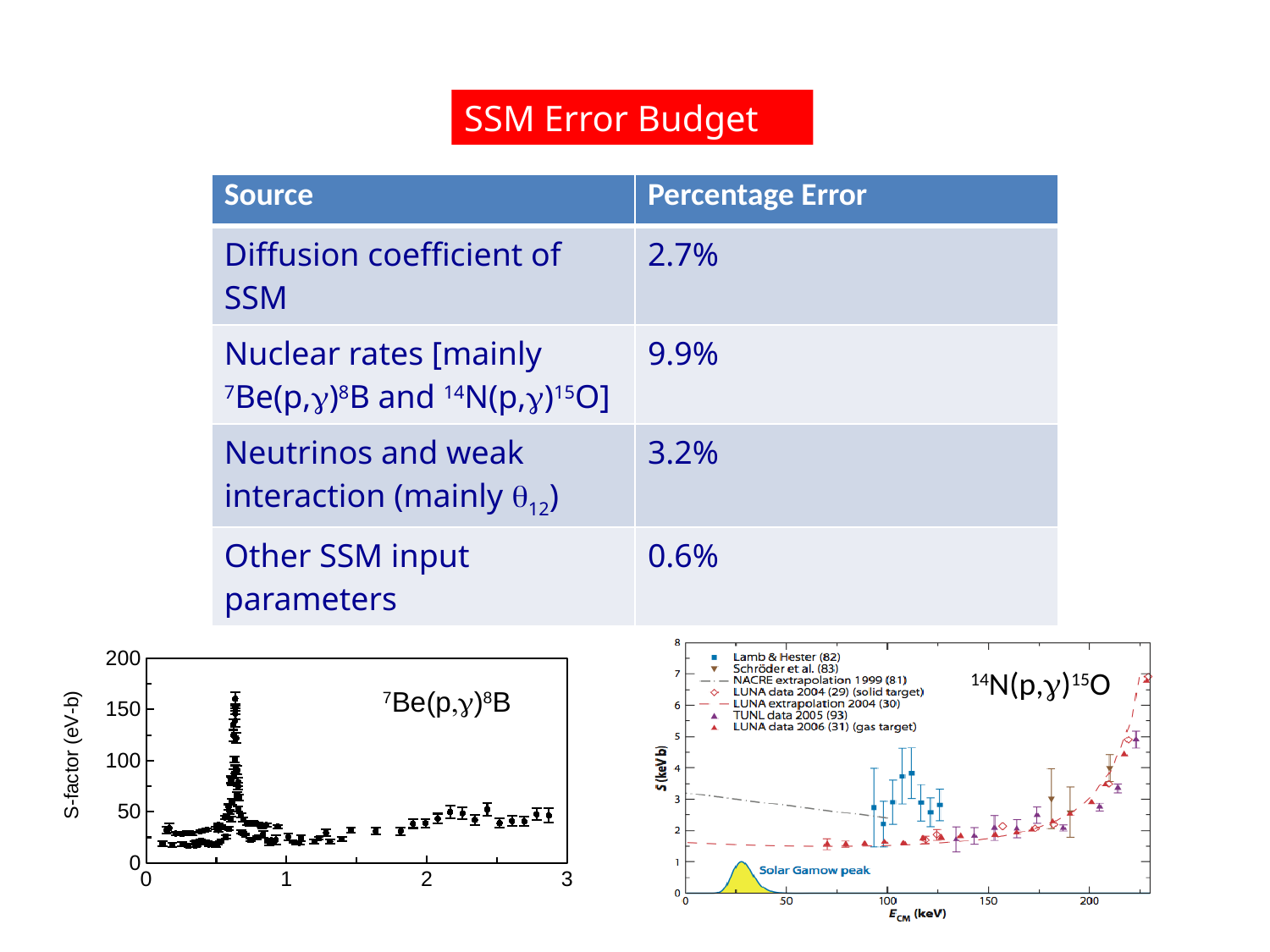
In the bottom-right 14N(p,γ)15O chart, are the LUNA data 2006 (gas target) points near 100 keV greater or less than 2 keV b? less How many data series does the legend of the bottom-right 14N(p,γ)15O chart list? 7 In the bottom-right 14N(p,γ)15O chart, do the S-factor values rise or fall as E_CM increases from 150 keV to 230 keV? rise What is the y-axis label of the bottom-left 7Be(p,γ)8B chart? S-factor (eV-b) In the bottom-right 14N(p,γ)15O chart, is the S-factor value of the highest data point near 230 keV greater or less than 6? greater In the bottom-right 14N(p,γ)15O chart, which is larger: the S-factor of the data points near 220 keV or the S-factor of the data points near 100 keV? near 220 keV In the bottom-left 7Be(p,γ)8B chart, what is the highest value shown on the y-axis? 200 In the bottom-left 7Be(p,γ)8B chart, is the peak S-factor value near x = 0.65 greater or less than 100? greater In the bottom-right 14N(p,γ)15O chart, what is the shaded yellow region at low energy labelled? Solar Gamow peak What kind of chart is the bottom-left chart labelled 7Be(p,γ)8B? scatter plot